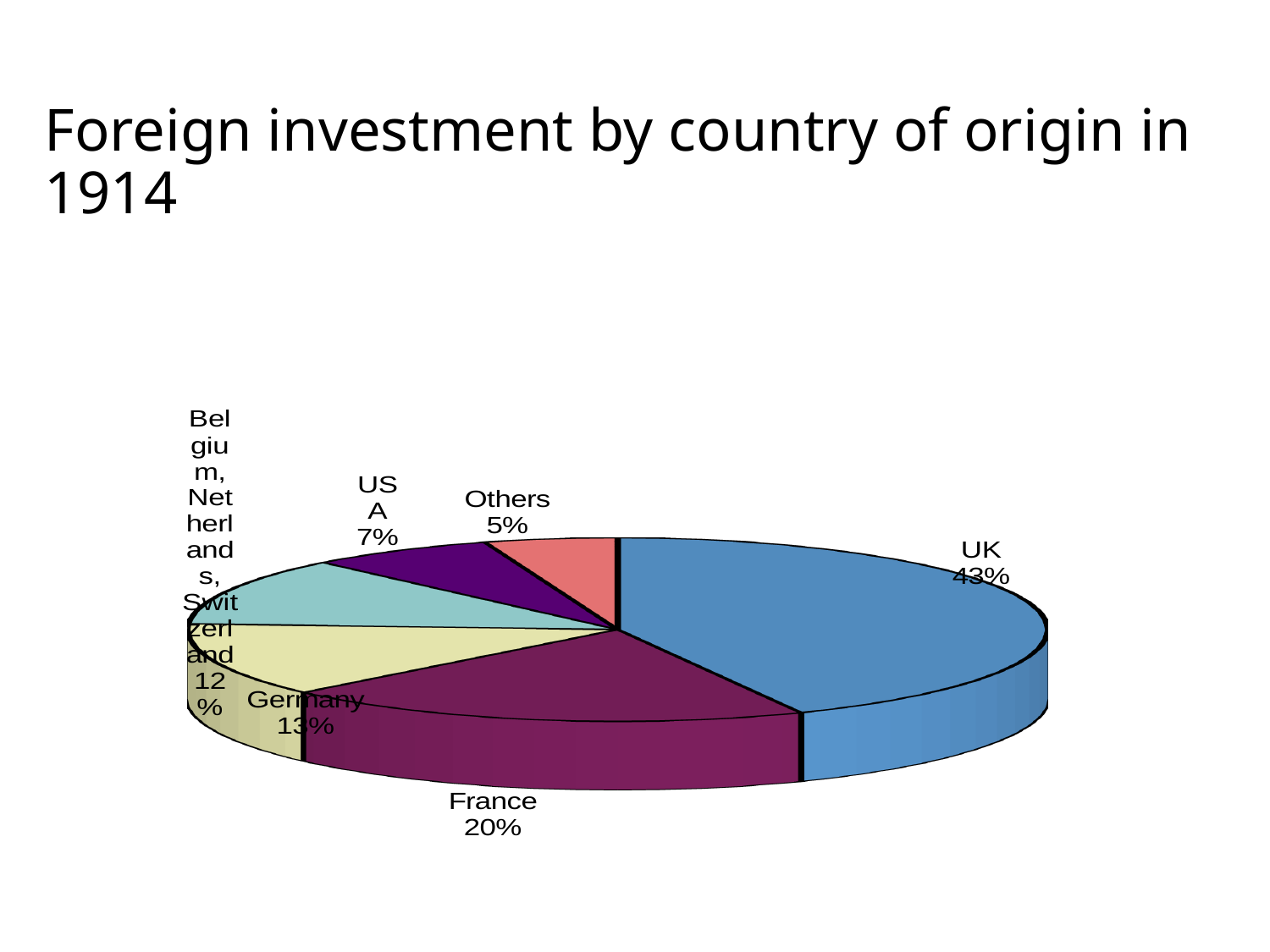
Which slice of the pie chart is the smallest? Others How many slices does the pie chart have? 6 Which country of origin has the largest share of foreign investment in 1914? UK What share of foreign investment in 1914 is labelled Others? 5% What share of foreign investment in 1914 came from the USA? 7% What share of foreign investment in 1914 came from France? 20% What share of foreign investment in 1914 came from Germany? 13% How many percentage points larger is the UK's share than France's share? 23 Which has a larger share of foreign investment in 1914, Germany or the USA? Germany What is the title of the slide? Foreign investment by country of origin in 1914 What kind of chart is shown on the slide? Pie chart What share of foreign investment in 1914 came from the UK? 43%